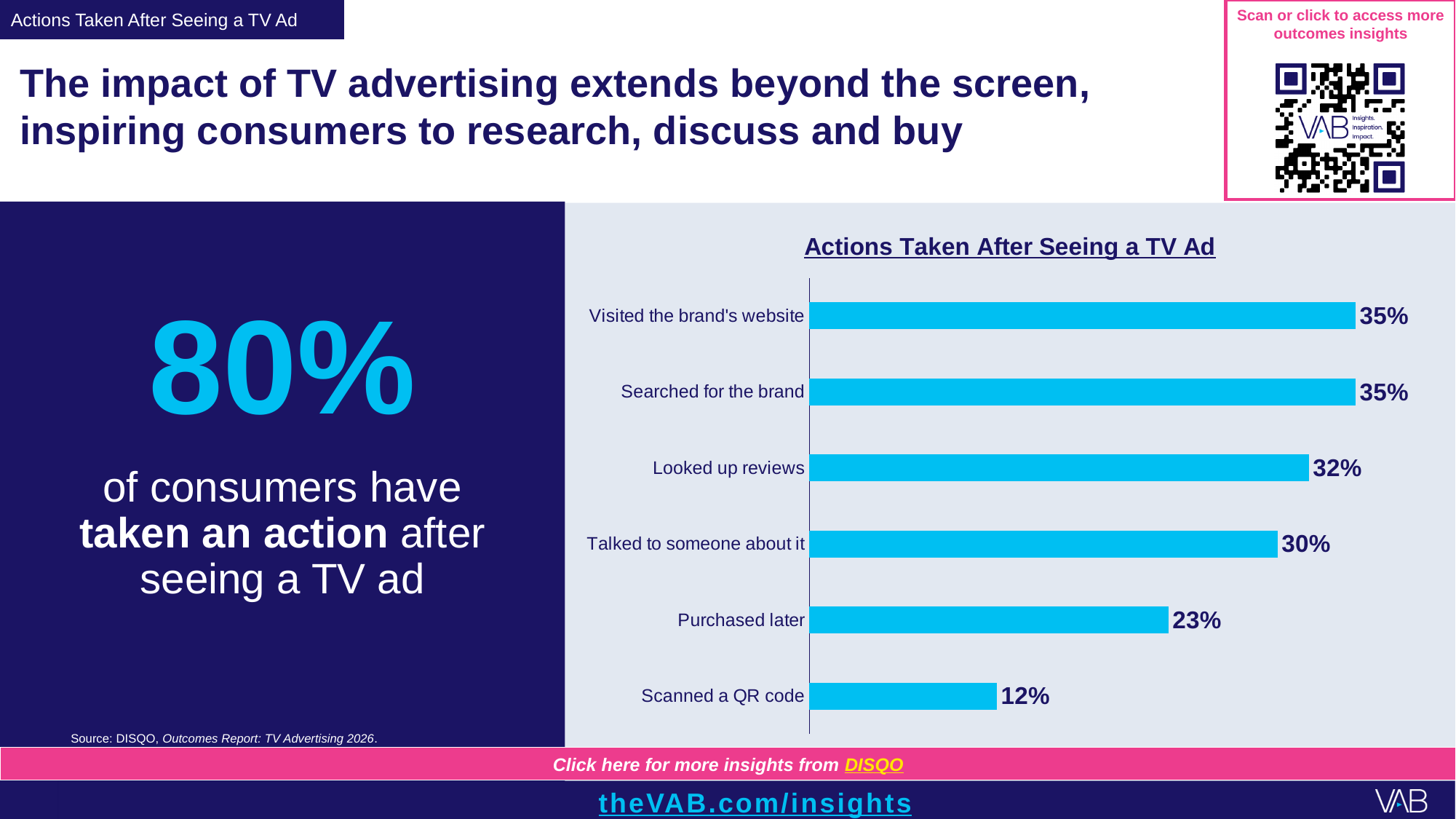
What kind of chart is shown on the slide? Bar chart What is the difference between 'Looked up reviews' and 'Purchased later'? 9% What is the value for 'Scanned a QR code'? 12% Which action has the lowest value in the chart? Scanned a QR code What colour are the bars in the chart? Light blue Which is larger: 'Talked to someone about it' or 'Purchased later'? Talked to someone about it How many actions are shown in the chart? 6 What is the value for 'Purchased later'? 23% What is the value for 'Looked up reviews'? 32% What is the difference between 'Talked to someone about it' and 'Scanned a QR code'? 18% What percentage of consumers visited the brand's website after seeing a TV ad? 35% What is the title of the chart? Actions Taken After Seeing a TV Ad